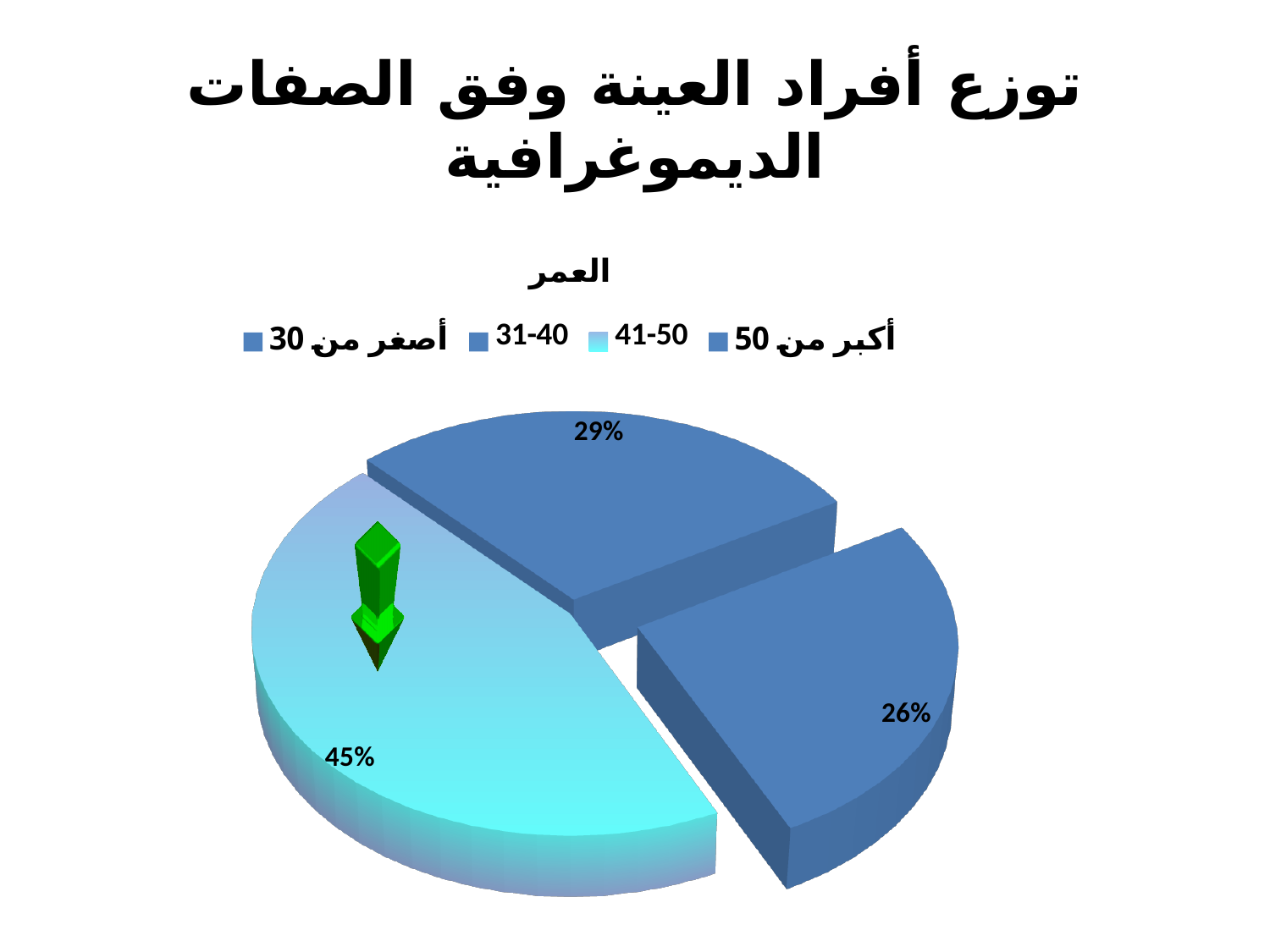
What is the difference in percentage points between the largest labelled slice (45%) and the smallest labelled slice (26%)? 19 What is the difference in percentage points between the 29% slice and the 26% slice? 3 What is the title of the chart? العمر What kind of chart is shown on the slide? pie chart How many slices of the pie have a percentage label? 3 Which age group has the largest share of the pie? 41-50 What is the smallest percentage labelled on the pie chart? 26% Which is larger: the 29% slice or the 26% slice? the 29% slice What percentage of the sample is in the 41-50 age group? 45% Is the share of the 41-50 age group greater or less than 40%? greater What is the largest percentage labelled on the pie chart? 45% How many categories does the chart legend list? 4